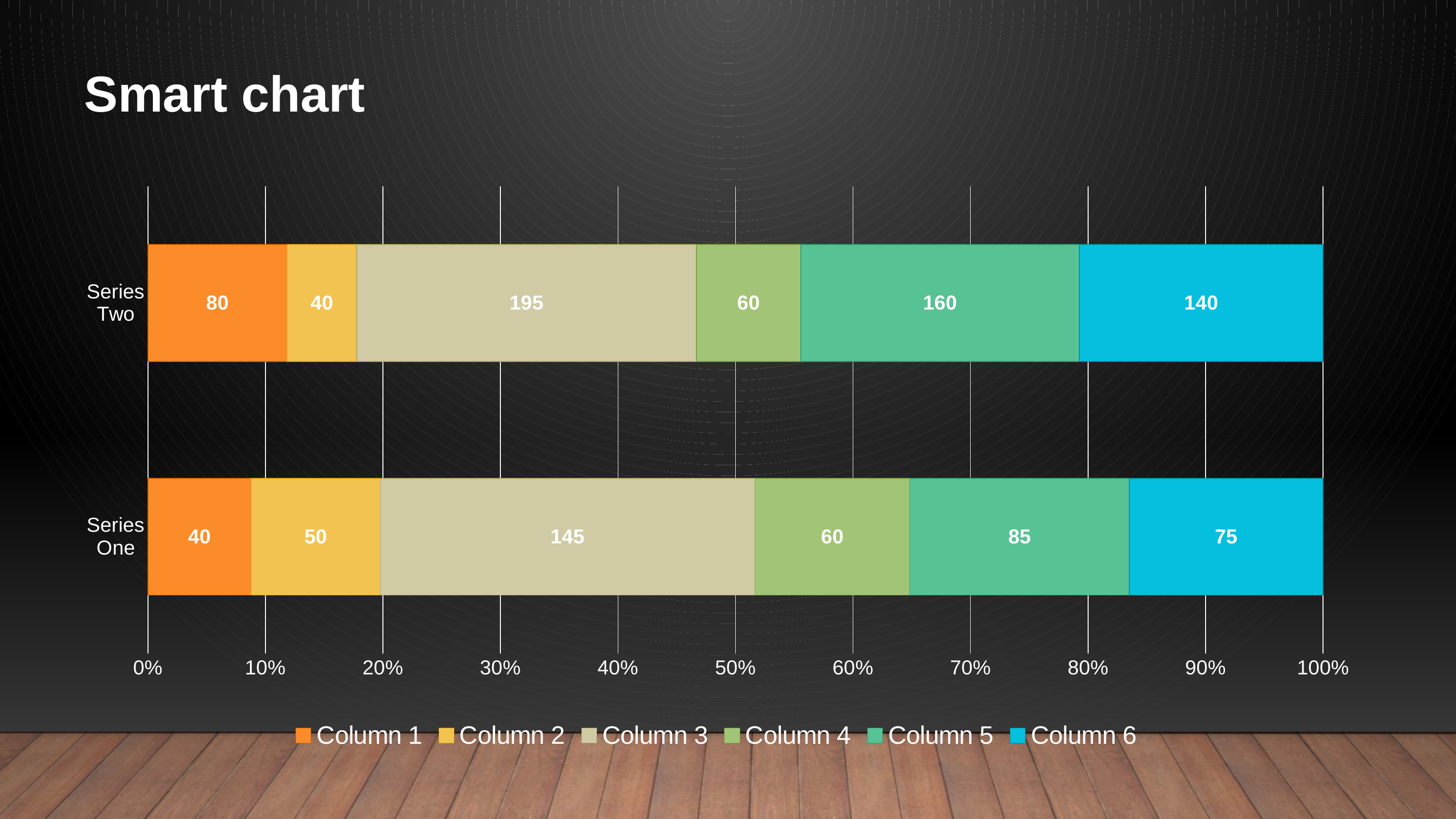
Which column has the lowest value for Series Two? Column 2 What type of chart is shown on the slide? Stacked bar chart What is the total of all segments in the Series Two bar? 675 How many series does the legend list? 6 What is the difference between the Column 5 values for Series Two and Series One? 75 How many categories (bars) are shown on the chart? 2 What is the value of Column 5 for Series One? 85 Which column has the highest value for Series One? Column 3 What is the value of Column 3 for Series Two? 195 What is the value of Column 1 for Series Two? 80 What is the total of all segments in the Series One bar? 455 Which is larger, Column 6 for Series Two or Column 6 for Series One? Series Two